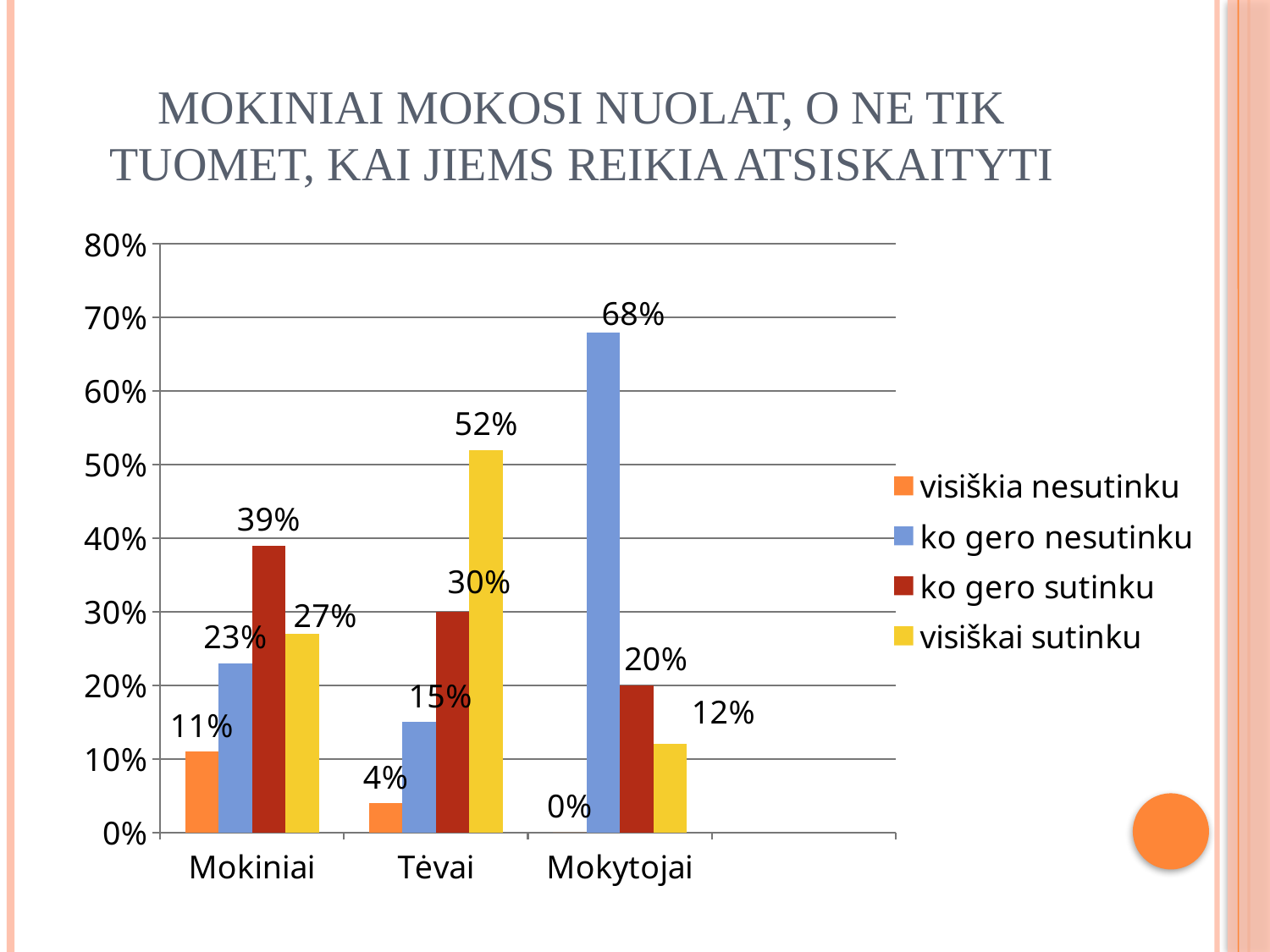
What is the value for 'ko gero nesutinku' in the Mokytojai category? 68% What is the difference between 'visiškai sutinku' for Tėvai and for Mokiniai? 25% What is the value for 'visiškai sutinku' in the Tėvai category? 52% How many categories are shown on the x axis? 3 What is the value for 'visiškia nesutinku' in the Mokiniai category? 11% Which category has the lowest value for 'visiškia nesutinku'? Mokytojai How many series does the legend list? 4 Which category has the highest value for 'ko gero nesutinku'? Mokytojai What kind of chart is shown on the slide? Bar chart What is the value for 'ko gero sutinku' in the Mokytojai category? 20% Which is larger: 'ko gero sutinku' for Mokiniai or 'ko gero sutinku' for Tėvai? Mokiniai Which colour represents the 'visiškai sutinku' series? Yellow